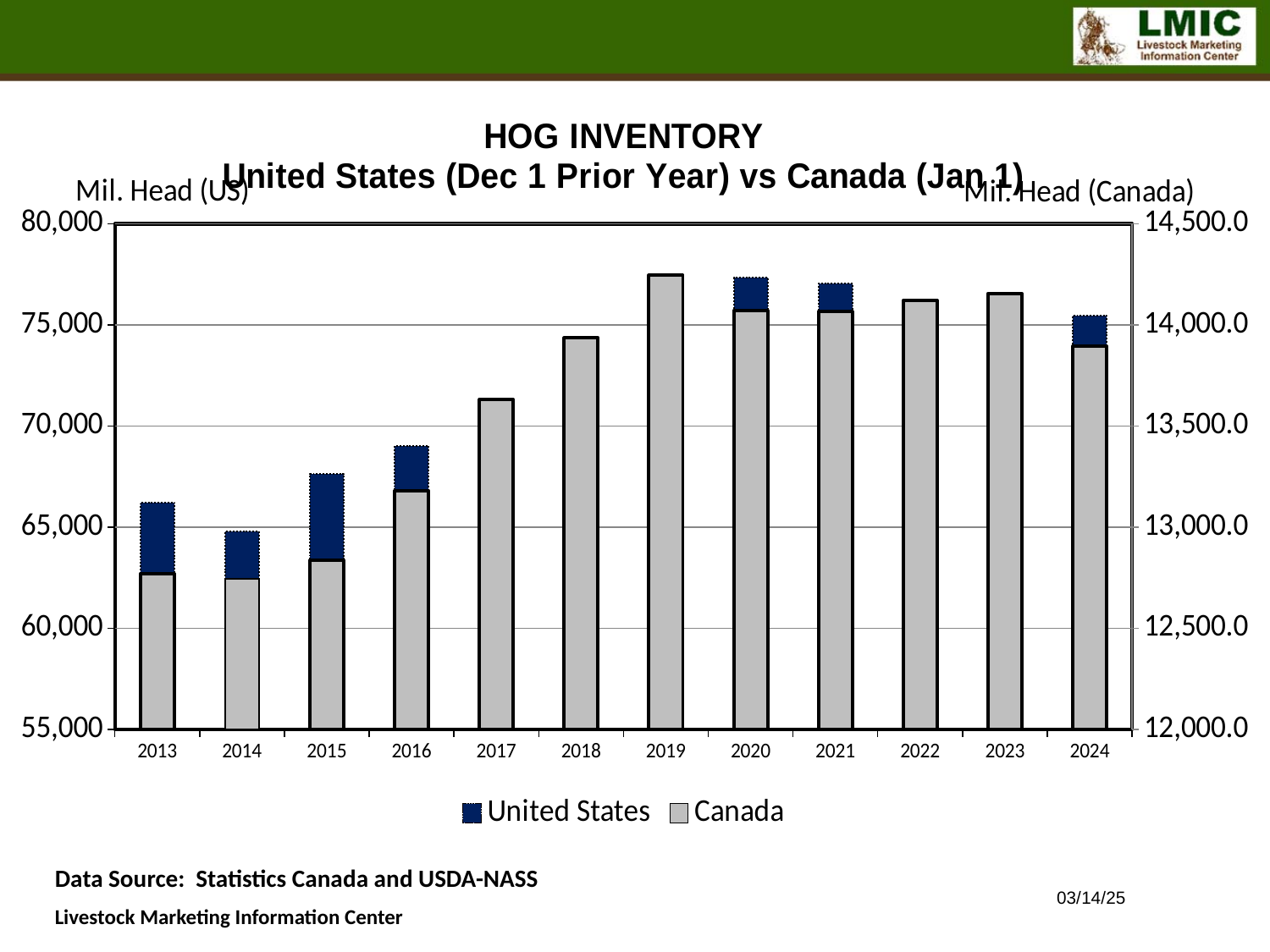
Which is larger, the Canada bar for 2018 or the Canada bar for 2017? 2018 How many years are shown on the x axis of the chart? 12 Is the United States value for 2013 greater or less than 65,000 on the left axis? greater Which series are listed in the legend? United States and Canada What is the title of the chart? HOG INVENTORY United States (Dec 1 Prior Year) vs Canada (Jan 1) Is the Canada value for 2013 greater or less than 13,000.0 on the right axis? less Do the Canada bars generally rise or fall from 2013 to 2019? rise How many series does the legend list? 2 In which year is the Canada bar highest? 2019 Is the United States value for 2016 greater or less than 70,000 on the left axis? less What kind of chart is shown on the slide? bar chart